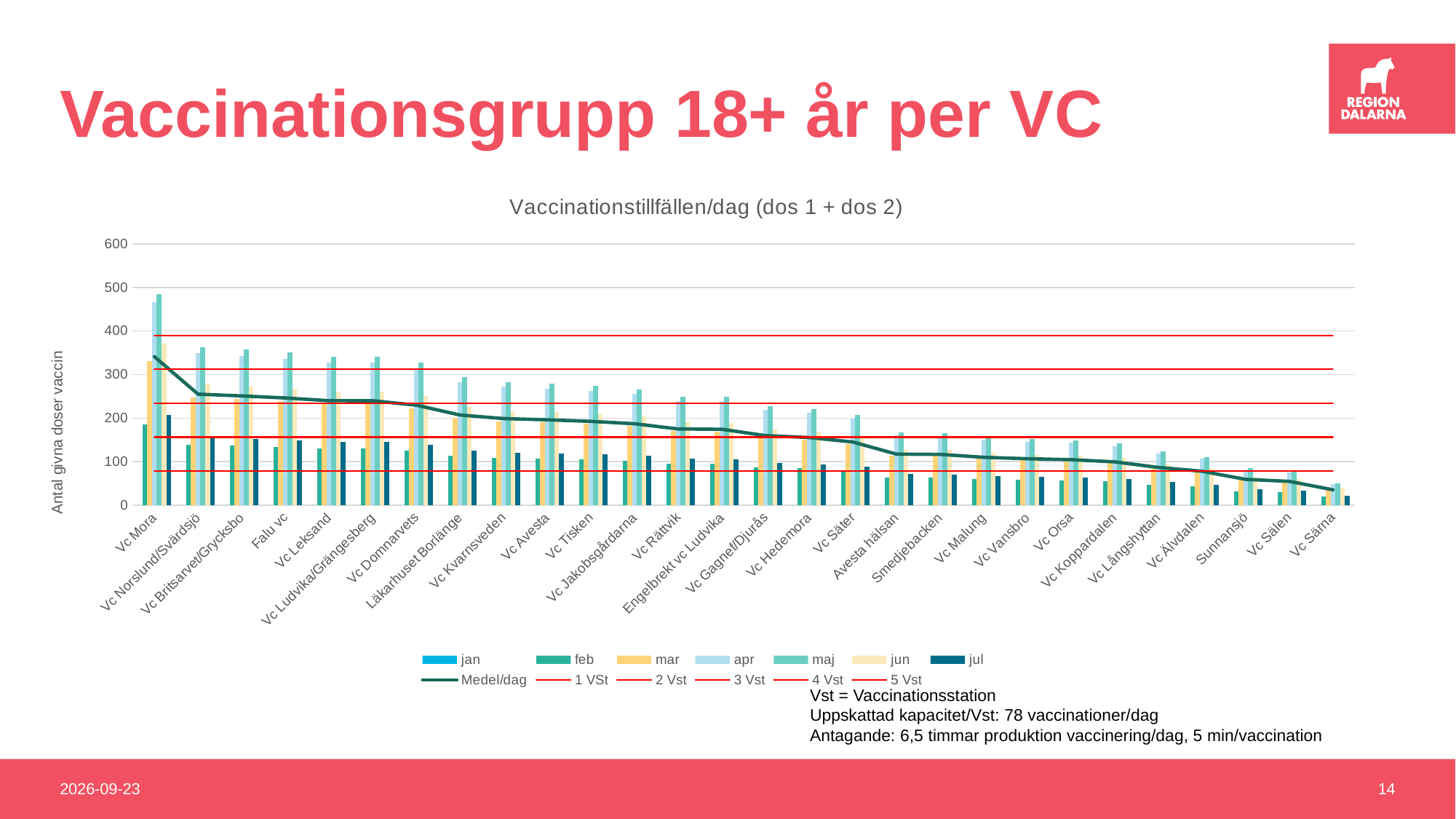
What kind of chart is shown on the slide? Bar chart with a line How many entries does the legend list? 13 Which is larger, the maj value for Vc Mora or the maj value for Vc Norslund/Svärdsjö? Vc Mora Is the Medel/dag value for Vc Mora greater or less than 300? greater Is the maj value for Vc Mora greater or less than 400? greater Which vaccination centre has the lowest Medel/dag value? Vc Särna What is the label on the y axis? Antal givna doser vaccin Which vaccination centre has the highest maj bar? Vc Mora How many vaccination centres (categories) are shown on the x axis? 28 Does the Medel/dag line rise or fall from left to right across the x axis? fall Is the maj value for Vc Särna greater or less than 100? less What is the title of the chart? Vaccinationstillfällen/dag (dos 1 + dos 2)